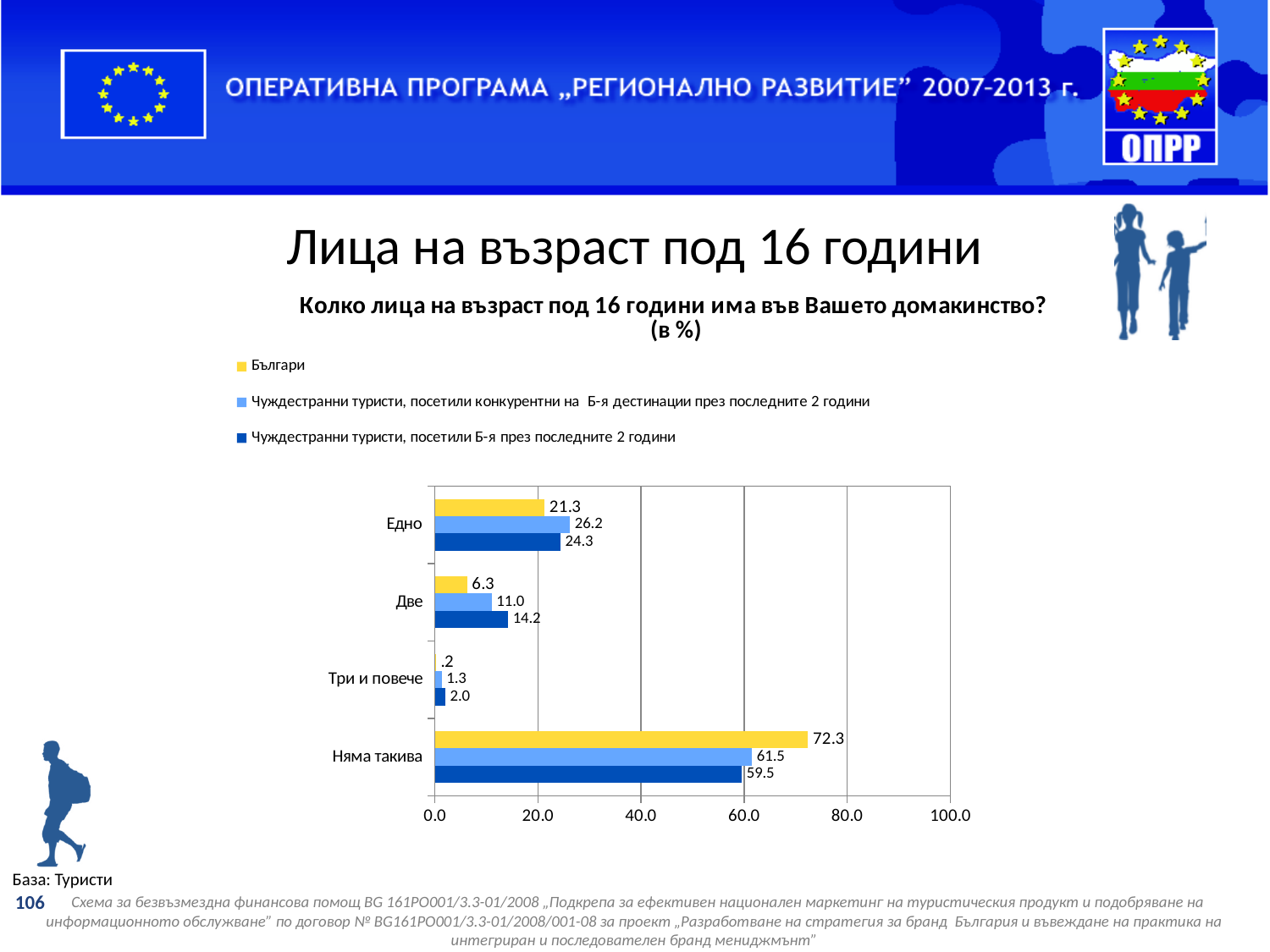
Which category has the highest value for Българи? Няма такива What is the value for Чуждестранни туристи, посетили конкурентни на Б-я дестинации през последните 2 години in the category Едно? 26.2 How many categories are shown on the chart's vertical axis? 4 How many series does the chart legend list? 3 What is the difference between the Българи value and the Чуждестранни туристи, посетили Б-я през последните 2 години value in the category Няма такива? 12.8 Which category has the lowest value for Чуждестранни туристи, посетили Б-я през последните 2 години? Три и повече What colour represents the series Българи in the chart? yellow Is the value for Чуждестранни туристи, посетили конкурентни на Б-я дестинации през последните 2 години in the category Няма такива greater or less than 60.0? greater What is the value for Българи in the category Няма такива? 72.3 What is the value for Чуждестранни туристи, посетили Б-я през последните 2 години in the category Две? 14.2 What type of chart is shown on the slide? bar chart In the category Две, which series has the larger value: Българи or Чуждестранни туристи, посетили конкурентни на Б-я дестинации през последните 2 години? Чуждестранни туристи, посетили конкурентни на Б-я дестинации през последните 2 години